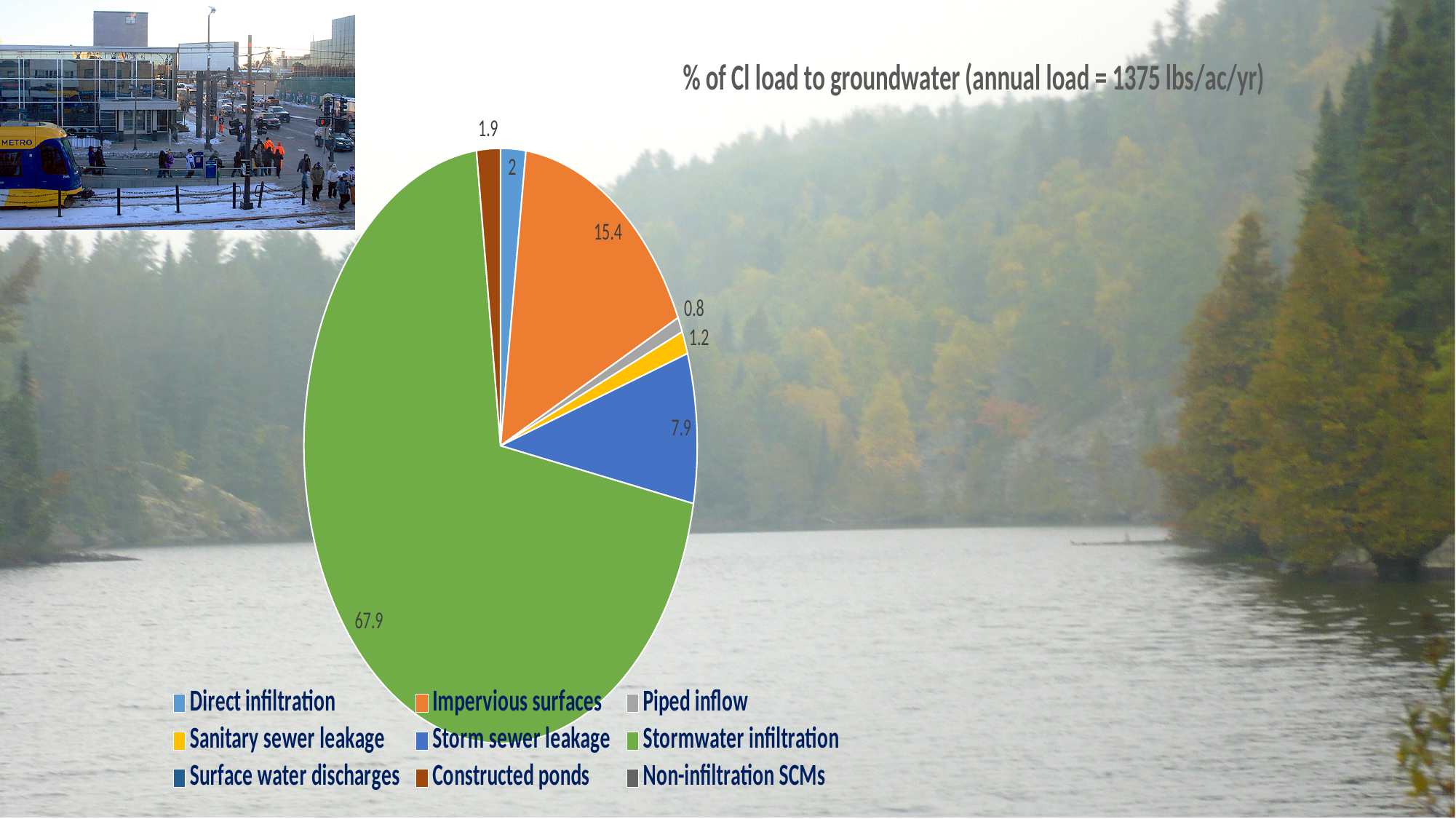
How many categories does the legend list? 9 What type of chart is shown on the slide? pie chart What percentage of the Cl load to groundwater comes from Stormwater infiltration? 67.9 What is the difference between the values for Stormwater infiltration and Impervious surfaces? 52.5 What value is shown for Constructed ponds? 1.9 What value is shown for Impervious surfaces? 15.4 What is the title of the chart? % of Cl load to groundwater (annual load = 1375 lbs/ac/yr) What value is shown for Direct infiltration? 2 Which is larger, the value for Impervious surfaces or the value for Storm sewer leakage? Impervious surfaces What value is shown for Storm sewer leakage? 7.9 Which category accounts for the largest share of the Cl load to groundwater? Stormwater infiltration What value is shown for Sanitary sewer leakage? 1.2